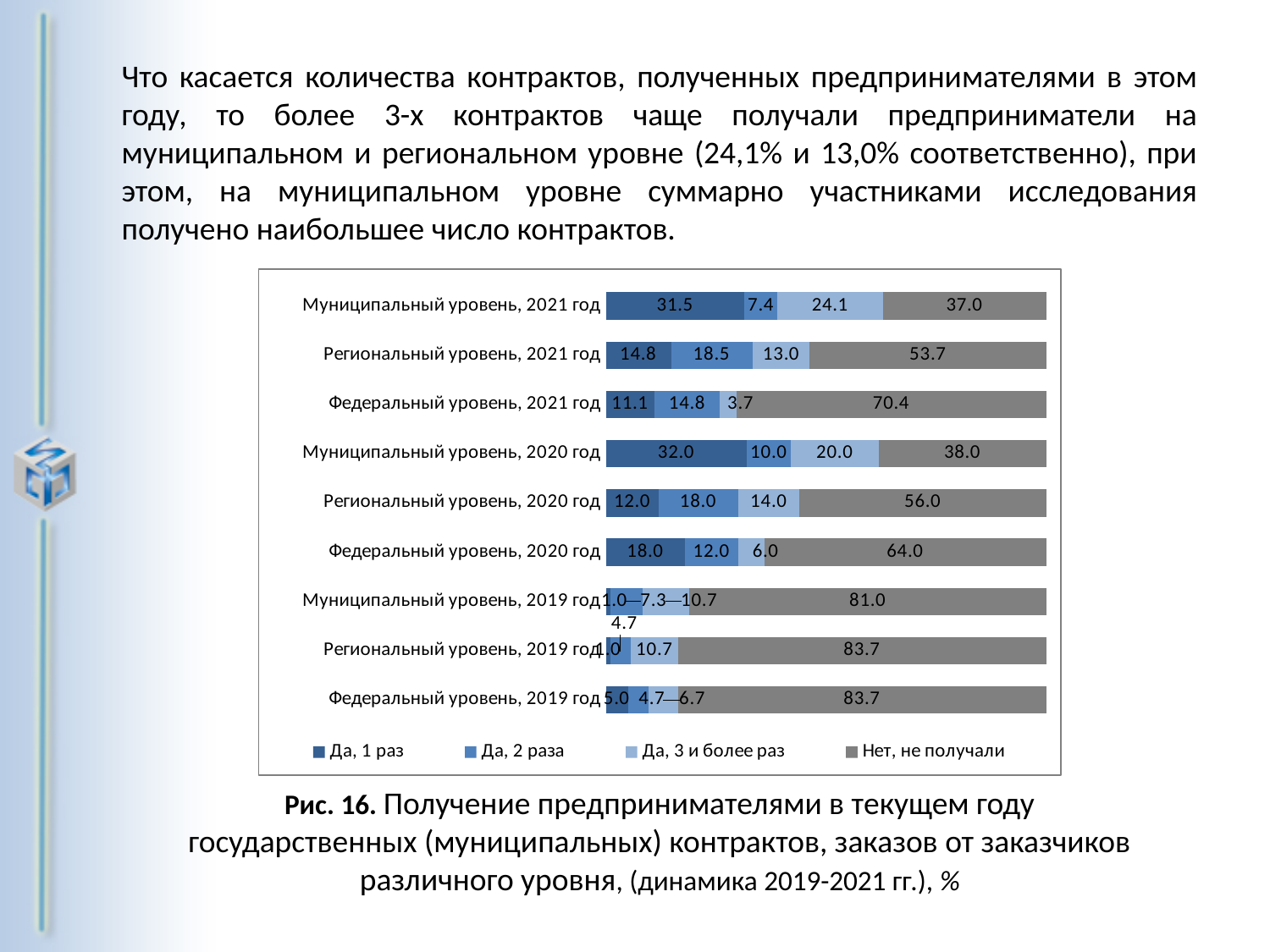
Which category has the lowest value for 'Да, 3 и более раз'? Федеральный уровень, 2021 год How many categories (bars) are shown in the chart? 9 Which category has the highest value for 'Да, 3 и более раз'? Муниципальный уровень, 2021 год What kind of chart is shown on the slide? Stacked bar chart What is the difference between the 'Нет, не получали' values for 'Федеральный уровень, 2021 год' and 'Региональный уровень, 2021 год'? 16.7 What is the value for 'Нет, не получали' in the 'Федеральный уровень, 2021 год' bar? 70.4 Which has the larger 'Да, 1 раз' value: 'Федеральный уровень, 2020 год' or 'Федеральный уровень, 2021 год'? Федеральный уровень, 2020 год Which colour represents the 'Нет, не получали' series in the chart? Grey How many series does the legend list? 4 What is the value for 'Да, 1 раз' in the 'Муниципальный уровень, 2020 год' bar? 32.0 What is the total of the 'Муниципальный уровень, 2021 год' stacked bar? 100.0 What is the value for 'Да, 3 и более раз' in the 'Муниципальный уровень, 2021 год' bar? 24.1